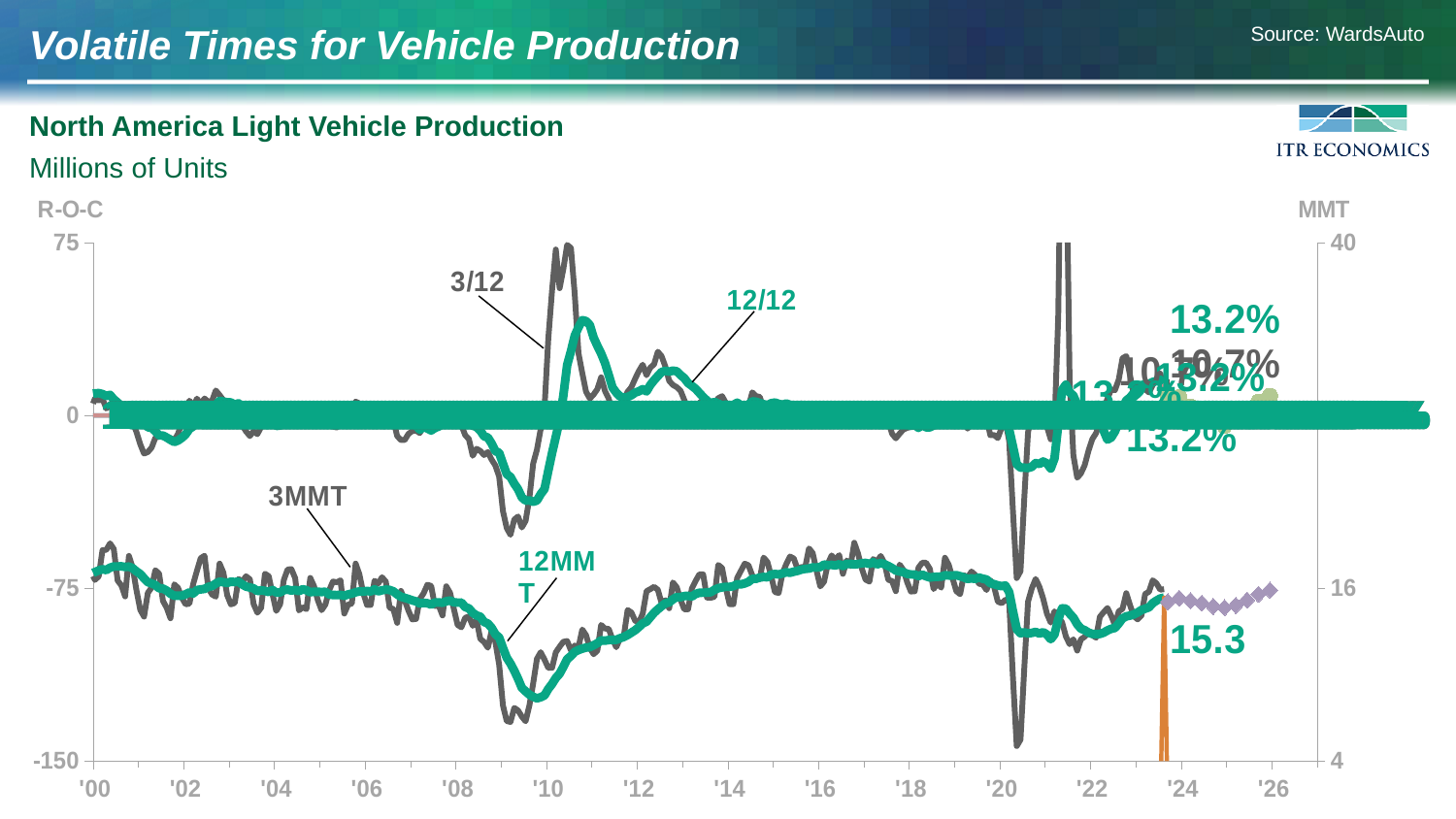
In what units is the chart's data expressed, according to the subtitle? Millions of Units Is the 12MMT value around 2009 greater or less than 16 on the MMT axis? less Does the 12MMT line rise or fall between 2010 and 2016? rise What is the title of the chart? North America Light Vehicle Production What is the earliest year shown on the x axis? '00 What type of chart is shown on the slide? line chart What is the highest value shown on the left R-O-C axis? 75 What value is labeled on the 12MMT line at its most recent data point (around 2023)? 15.3 How many data series are labeled on the chart (3/12, 12/12, 3MMT, 12MMT)? 4 Is the 12/12 rate-of-change at its peak around 2010-2011 greater or less than 0? greater What is the highest value shown on the right MMT axis? 40 What is the lowest value shown on the left R-O-C axis? -150